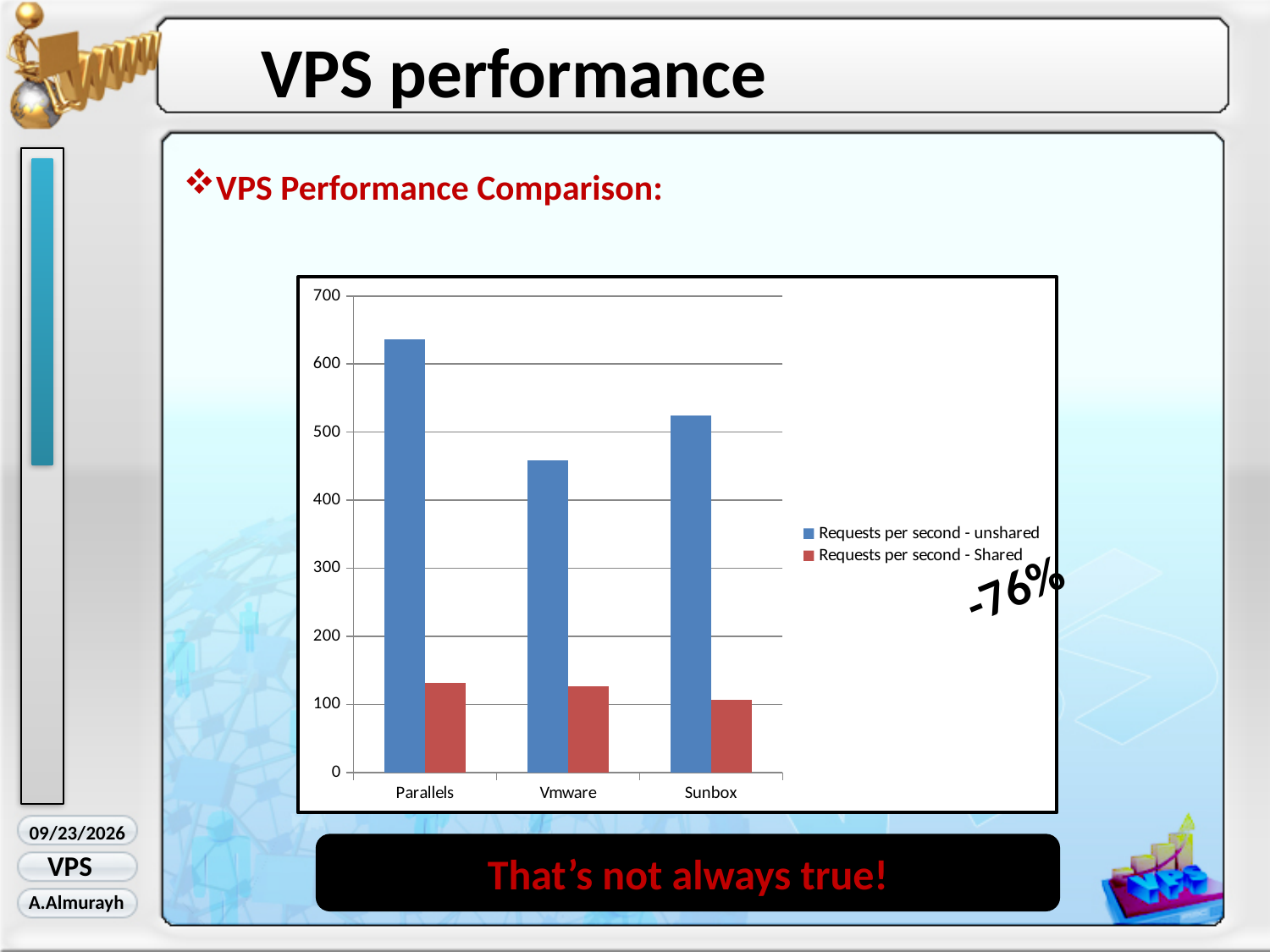
Is the value for Requests per second - Shared for Parallels greater or less than 200? less Which category has the highest value for Requests per second - unshared? Parallels Which is larger for Sunbox: Requests per second - unshared or Requests per second - Shared? Requests per second - unshared Which is larger for Requests per second - unshared: Sunbox or Vmware? Sunbox Which category has the lowest value for Requests per second - Shared? Sunbox How many series does the legend list? 2 Is the value for Requests per second - unshared for Parallels greater or less than 600? greater Is the value for Requests per second - unshared for Vmware greater or less than 500? less How many categories are shown on the x axis? 3 Which category has the lowest value for Requests per second - unshared? Vmware What kind of chart is shown on the slide? bar chart What colour are the bars for Requests per second - Shared? red